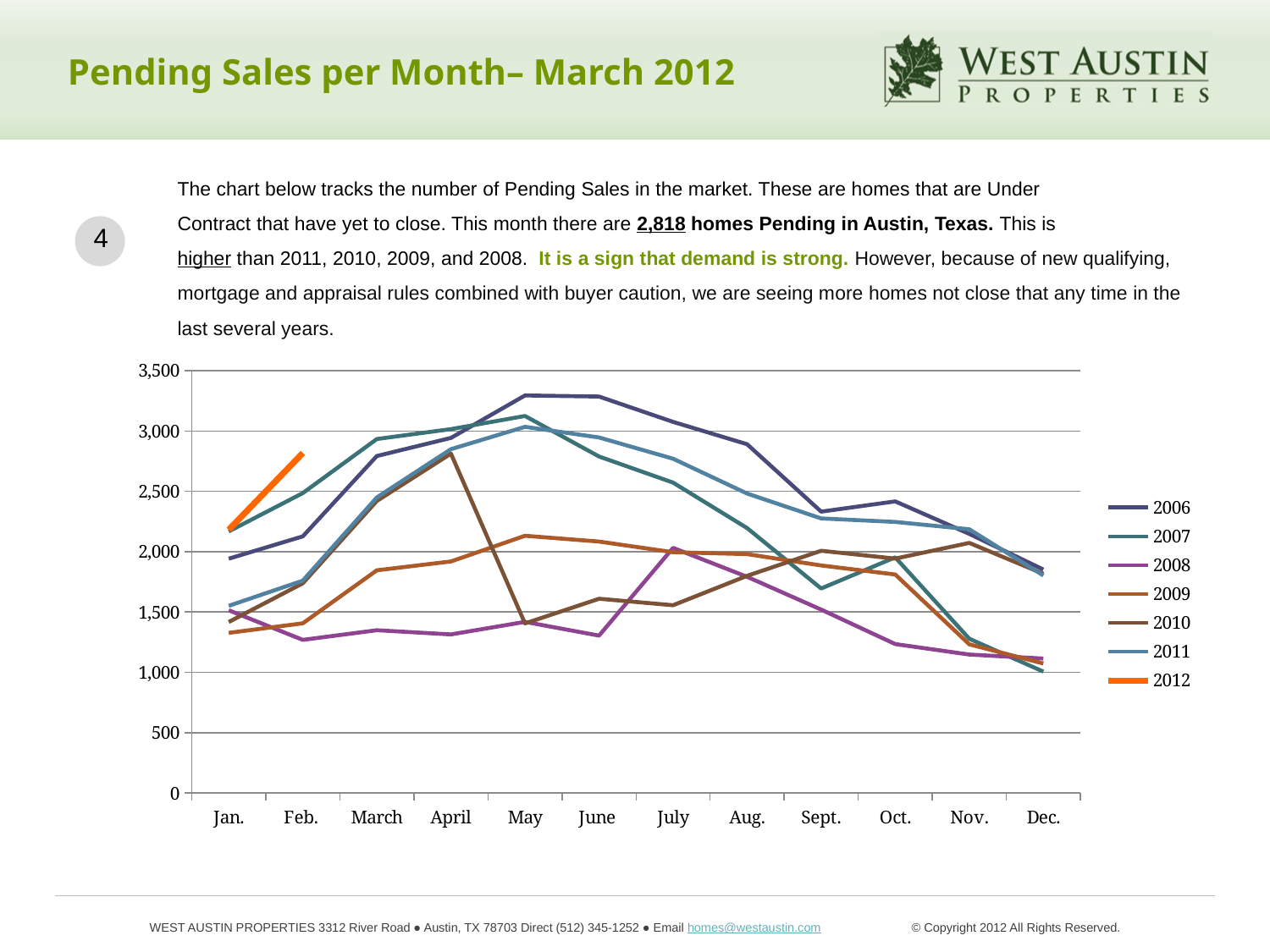
Is the value for 2007 in Sept. greater or less than 2,000? less Is the value for 2008 in Feb. greater or less than 1,500? less How many months are shown along the x axis of the chart? 12 Is the value for 2006 in June greater or less than 3,000? greater What kind of chart is shown on the slide? line chart How many series does the chart's legend list? 7 Which year has the highest value in June? 2006 In which month does the 2010 line reach its highest value? April In March, which is larger: the value for 2007 or the value for 2008? 2007 Does the 2008 line rise or fall from Aug. to Nov.? fall Which year has the lowest value in June? 2008